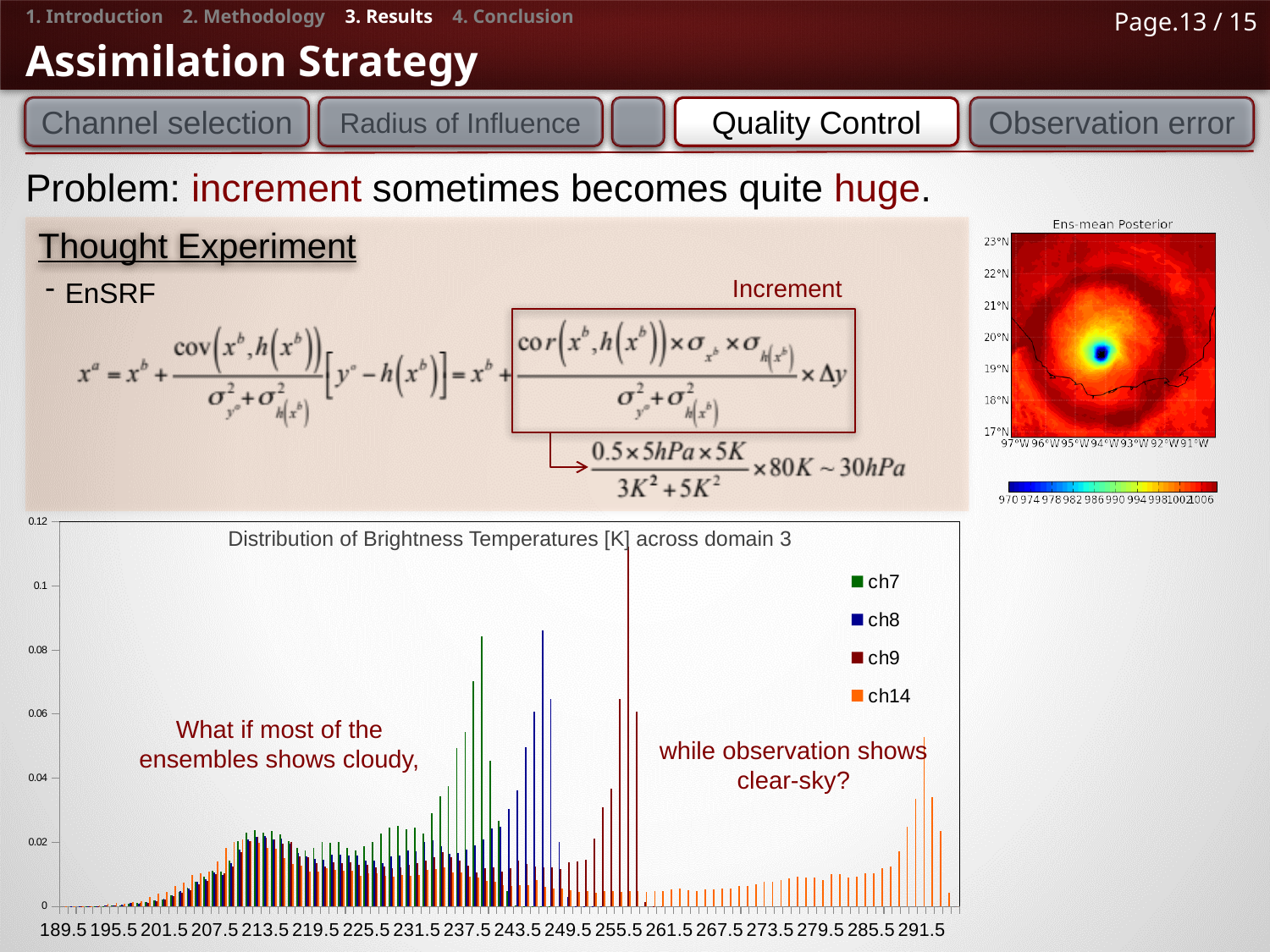
In the brightness temperature distribution chart, is the peak value of ch8 greater or less than 0.06? greater What kind of chart is the 'Distribution of Brightness Temperatures [K] across domain 3' chart? bar chart How many tick labels are shown on the x axis of the brightness temperature distribution chart? 18 How many series does the legend of the brightness temperature distribution chart list? 4 In the brightness temperature distribution chart, is the peak value of ch14 greater or less than 0.04? greater What are the series names in the legend of the brightness temperature distribution chart? ch7, ch8, ch9, ch14 What is the title of the bar chart at the bottom of the slide? Distribution of Brightness Temperatures [K] across domain 3 In the brightness temperature distribution chart, is the peak value of ch9 greater or less than 0.1? greater In the brightness temperature distribution chart, which series reaches the highest peak value? ch9 In the brightness temperature distribution chart, which series has a higher peak, ch7 or ch14? ch7 What is the highest tick value shown on the y axis of the brightness temperature distribution chart? 0.12 In the brightness temperature distribution chart, which series has a higher peak, ch9 or ch14? ch9